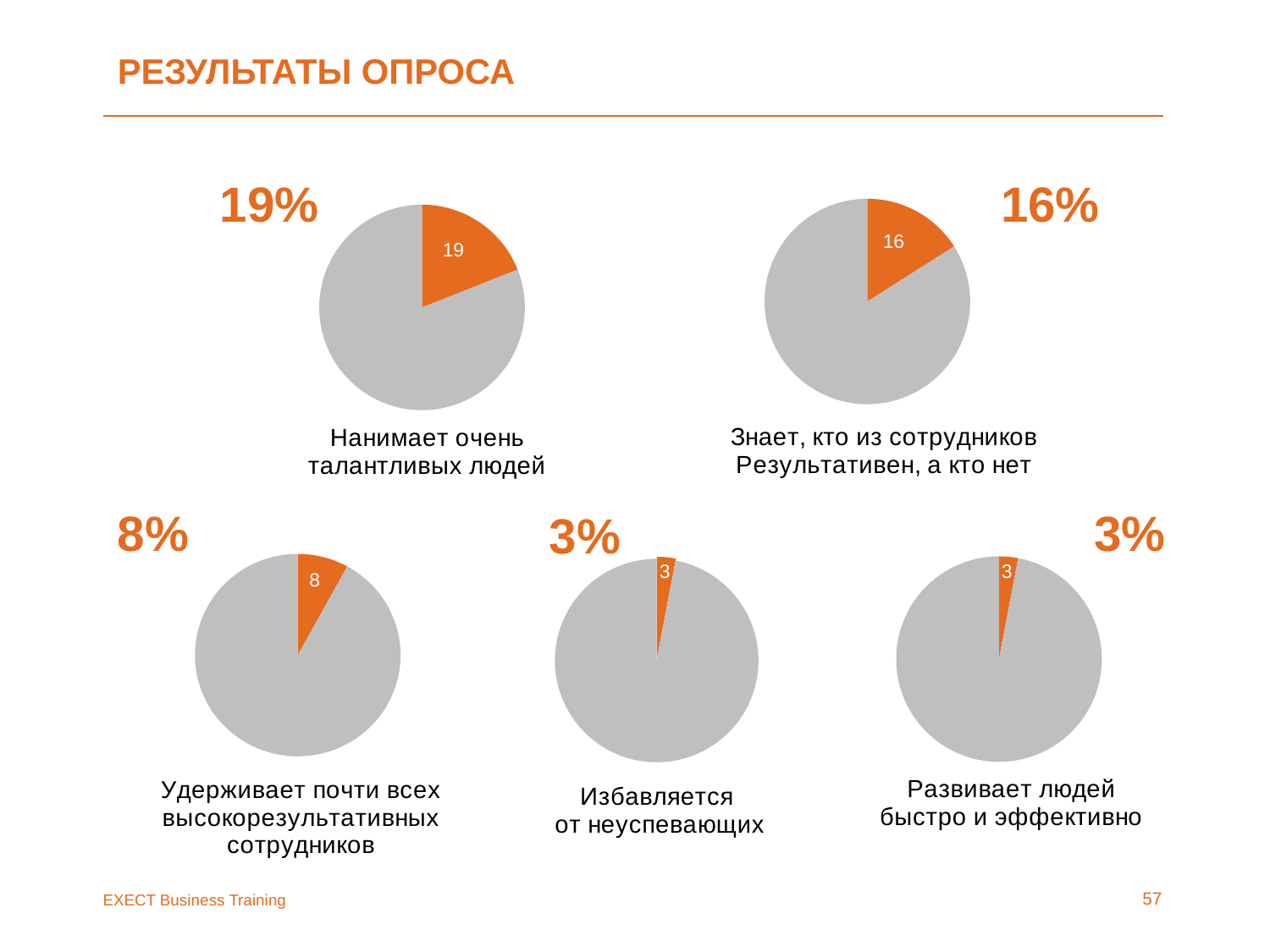
In the pie chart "Избавляется от неуспевающих", what value is printed on the orange slice? 3 What percentage is shown next to the pie chart "Развивает людей быстро и эффективно"? 3% What percentage is shown next to the pie chart "Нанимает очень талантливых людей"? 19% Which orange slice is larger: the one in "Знает, кто из сотрудников Результативен, а кто нет" or the one in "Удерживает почти всех высокорезультативных сотрудников"? Знает, кто из сотрудников Результативен, а кто нет What is the difference between the orange slice values in "Нанимает очень талантливых людей" and "Знает, кто из сотрудников Результативен, а кто нет"? 3 What is the title of the slide containing the pie charts? РЕЗУЛЬТАТЫ ОПРОСА How many pie charts are on the slide? 5 What kind of chart is used for "Нанимает очень талантливых людей"? pie chart Which pie chart has the largest orange slice? Нанимает очень талантливых людей In the pie chart "Знает, кто из сотрудников Результативен, а кто нет", what value is printed on the orange slice? 16 In the pie chart "Удерживает почти всех высокорезультативных сотрудников", what value is printed on the orange slice? 8 In the pie chart "Нанимает очень талантливых людей", what value is printed on the orange slice? 19